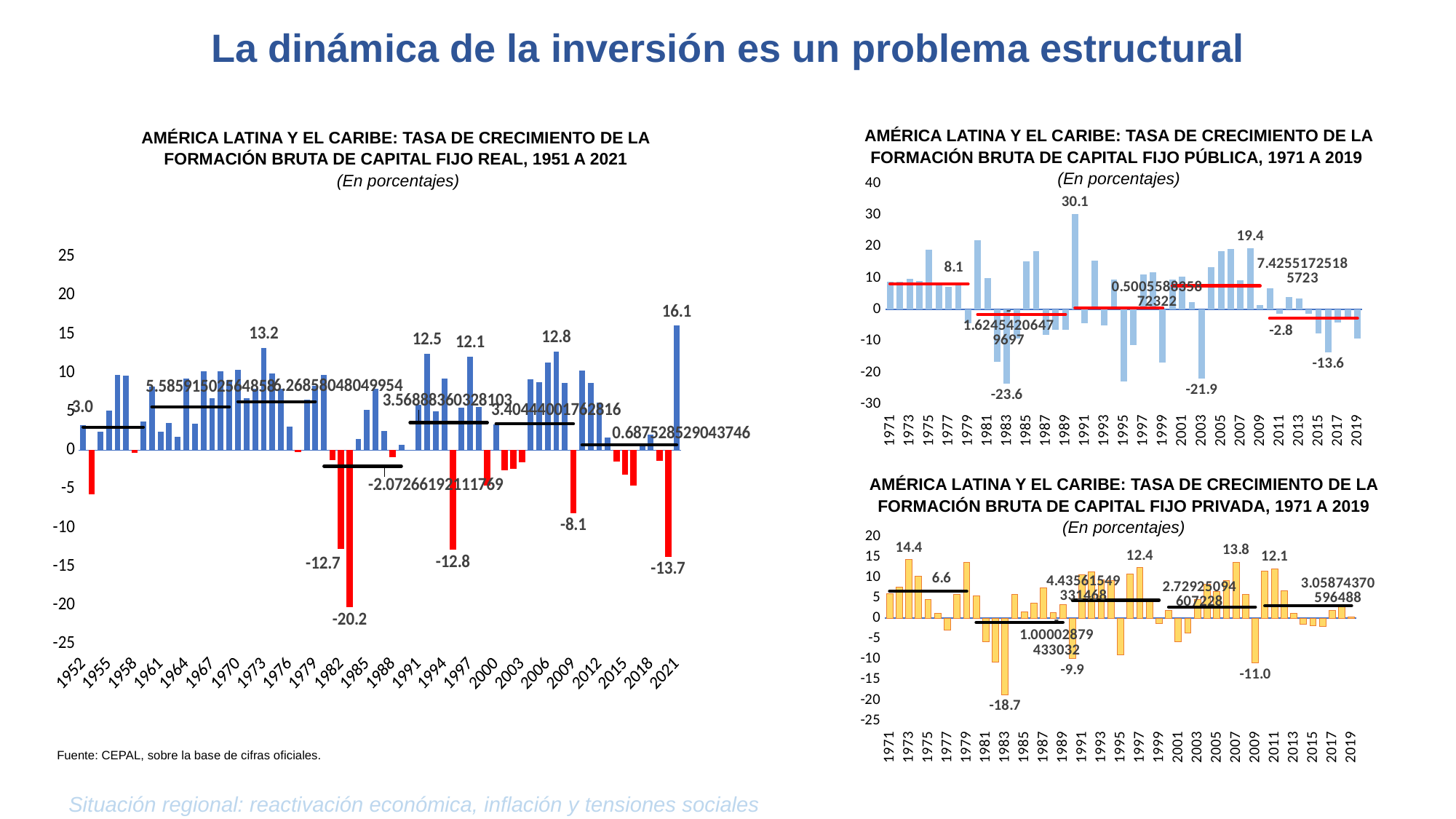
In the left chart (formación bruta de capital fijo real, 1951 a 2021), what is the value for 2020? -13.7 In the bottom-right chart (formación bruta de capital fijo privada, 1971 a 2019), what is the highest value shown? 14.4 In the left chart (formación bruta de capital fijo real, 1951 a 2021), what is the lowest value shown? -20.2 In the top-right chart (formación bruta de capital fijo pública, 1971 a 2019), what is the highest value shown? 30.1 In the left chart (formación bruta de capital fijo real, 1951 a 2021), what is the value for 2021? 16.1 What kind of chart is the left chart on fixed capital formation growth, 1951 to 2021? bar chart In the bottom-right chart (formación bruta de capital fijo privada, 1971 a 2019), what is the lowest value shown? -18.7 In the top-right chart (formación bruta de capital fijo pública, 1971 a 2019), what is the difference between the highest value 30.1 and the value labeled 19.4? 10.7 In the left chart (formación bruta de capital fijo real, 1951 a 2021), what is the value for 2009? -8.1 In the bottom-right chart (formación bruta de capital fijo privada, 1971 a 2019), which is larger, the value labeled 13.8 or the value labeled -11.0? 13.8 According to the source note, what organization's figures are the charts based on? CEPAL In the top-right chart (formación bruta de capital fijo pública, 1971 a 2019), what is the lowest value shown? -23.6